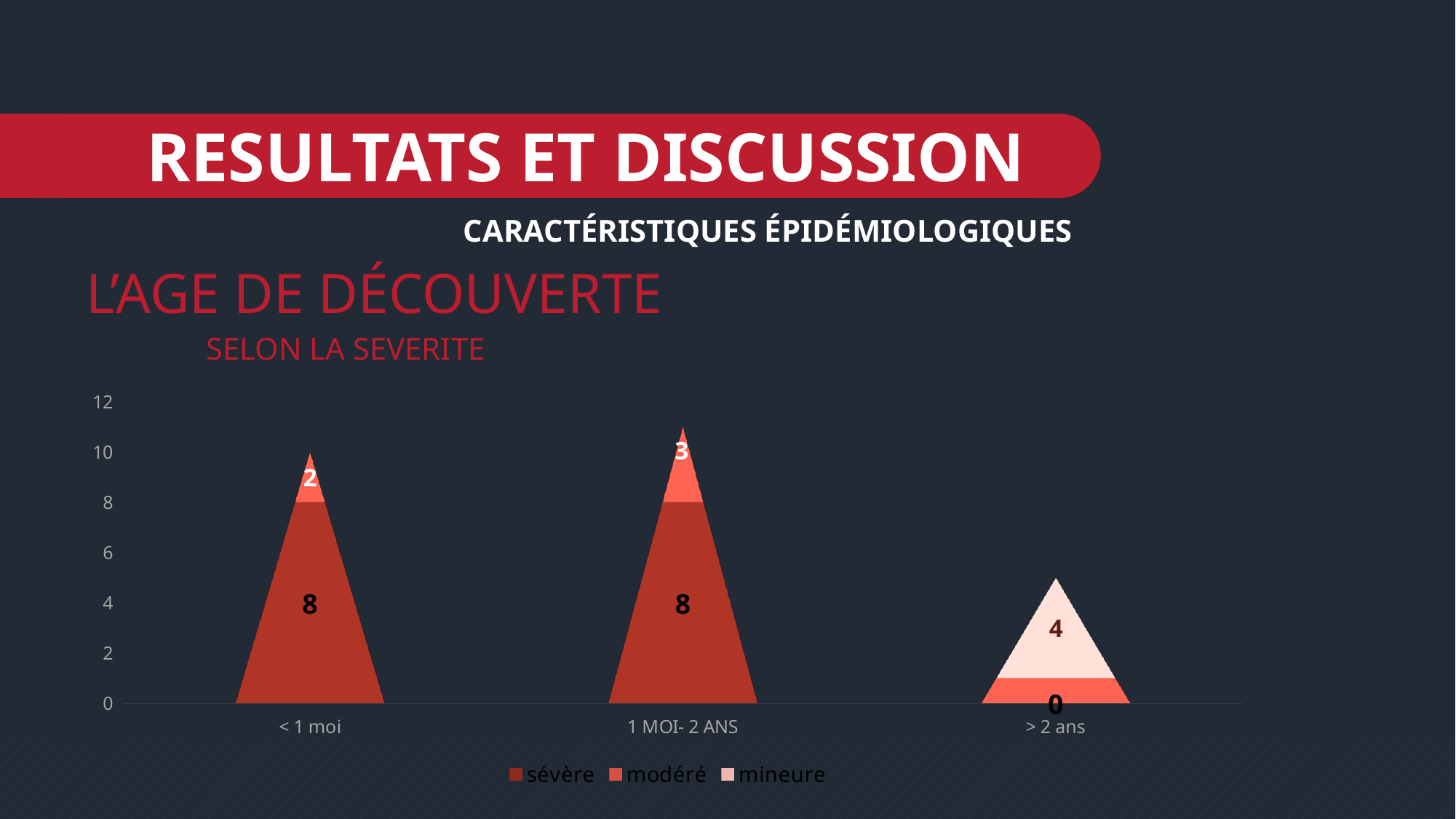
What is the total of the stacked bar for 1 MOI- 2 ANS? 11 Which category has the lowest total stacked bar? > 2 ans What is the value for modéré in the < 1 moi category? 2 What is the value for sévère in the > 2 ans category? 0 What is the value for modéré in the 1 MOI- 2 ANS category? 3 How many series does the legend list? 3 What is the value for sévère in the < 1 moi category? 8 What is the value for mineure in the > 2 ans category? 4 How many categories are shown on the x axis? 3 What is the difference between the modéré values for 1 MOI- 2 ANS and < 1 moi? 1 What is the total of the stacked bar for < 1 moi? 10 What kind of chart is shown on the slide? Stacked bar chart